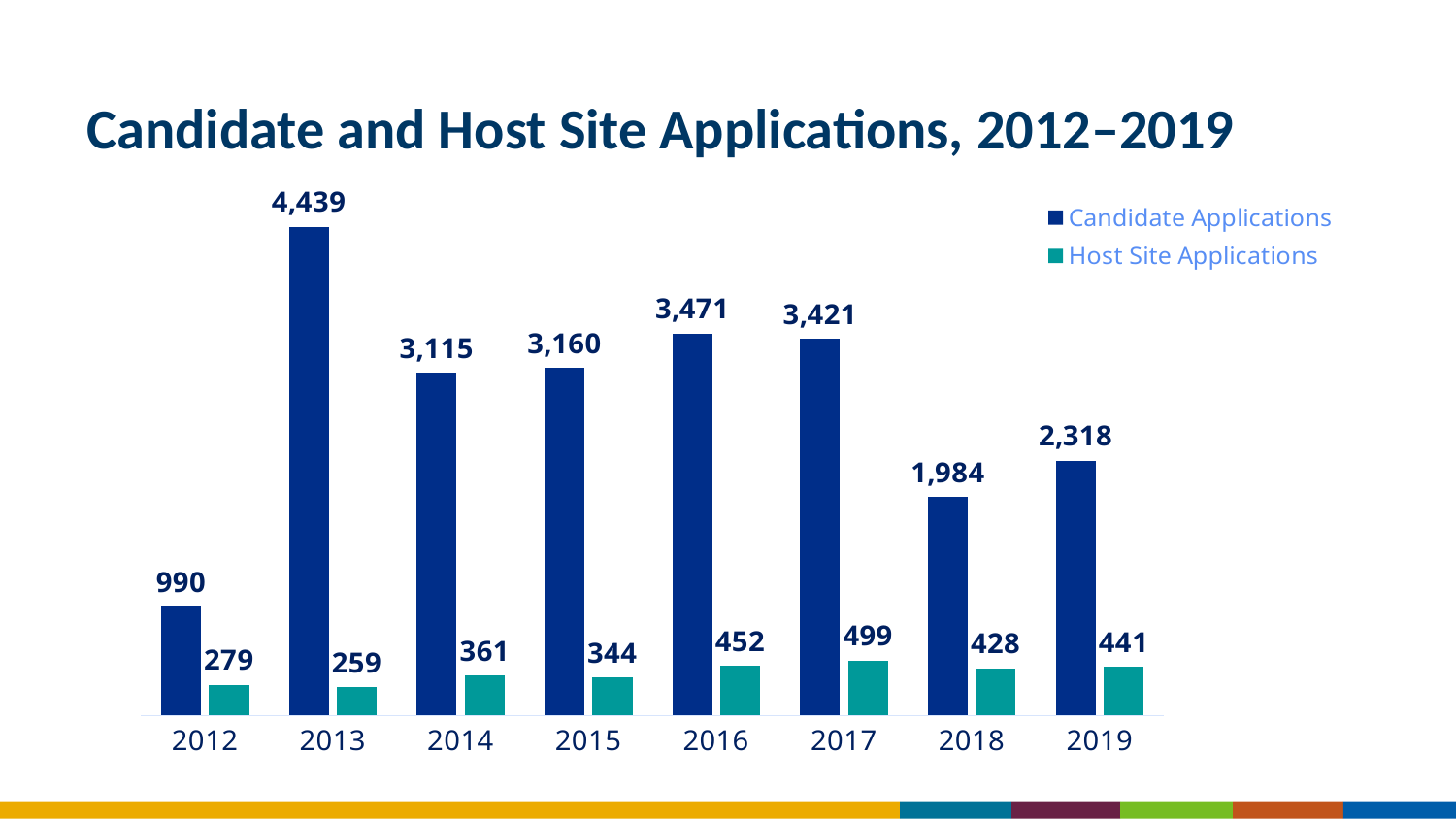
What is the title of the chart? Candidate and Host Site Applications, 2012-2019 Did Candidate Applications rise or fall from 2017 to 2018? Fall Which year had the lowest number of Host Site Applications? 2013 What is the difference between Host Site Applications in 2016 and 2012? 173 What is the difference between Candidate Applications in 2016 and 2017? 50 How many Candidate Applications were there in 2013? 4,439 How many series does the legend list? 2 Which year had the highest number of Candidate Applications? 2013 What kind of chart is shown on the slide? Bar chart How many Host Site Applications were there in 2017? 499 Which year had more Candidate Applications, 2018 or 2019? 2019 How many years are shown on the x axis? 8